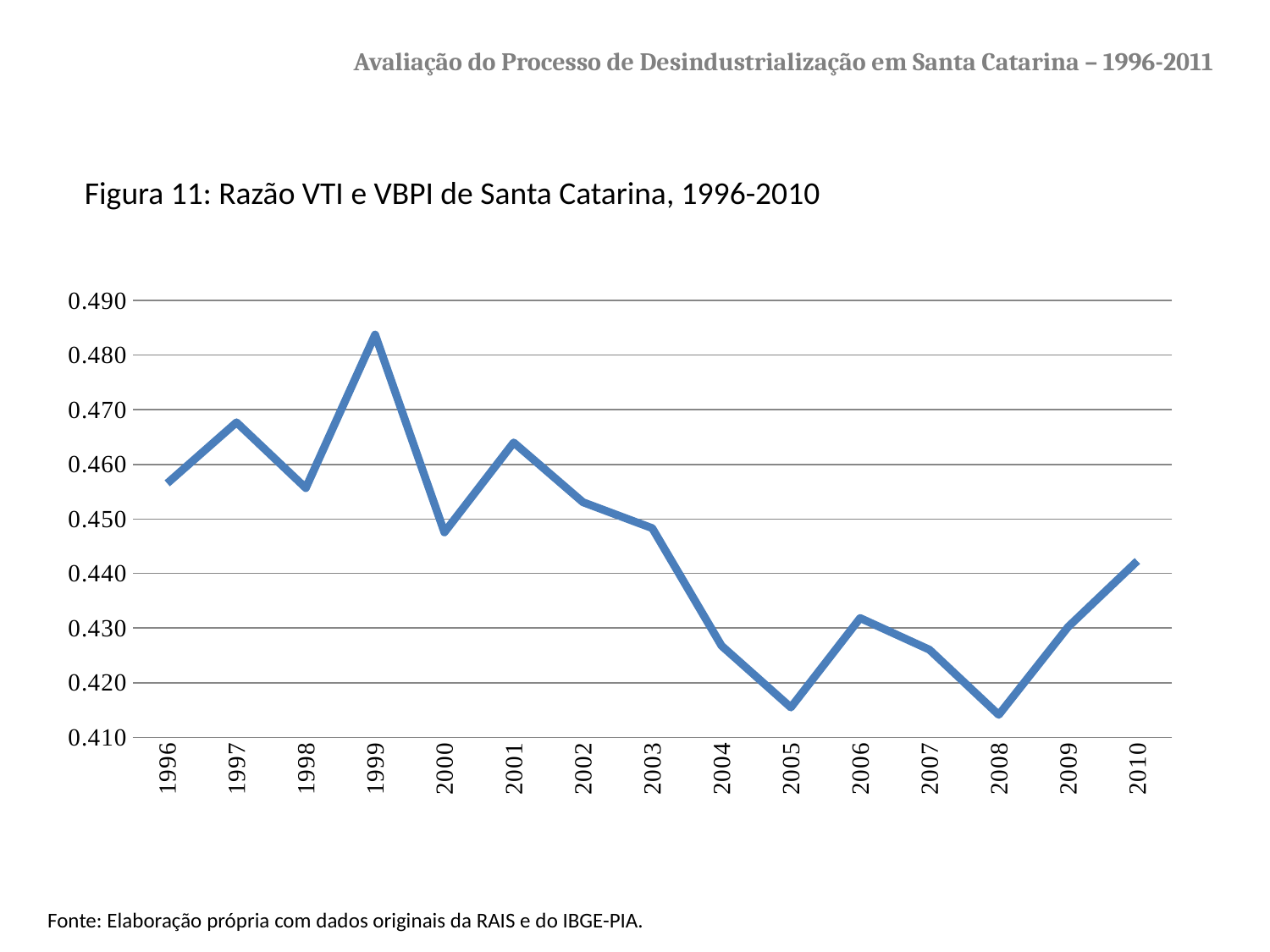
In which year does the VTI/VBPI ratio reach its highest value? 1999 Which year has the larger value, 2005 or 2006? 2006 Is the value for 2000 greater or less than 0.450? less Is the value for 2010 greater or less than 0.440? greater Is the value for 2005 greater or less than 0.420? less How many years are plotted along the x axis? 15 Overall, does the ratio rise or fall between 1996 and 2010? fall What is the title of the figure on the slide? Figura 11: Razão VTI e VBPI de Santa Catarina, 1996-2010 Which year has the larger value, 1999 or 2000? 1999 What kind of chart is shown on the slide? line chart